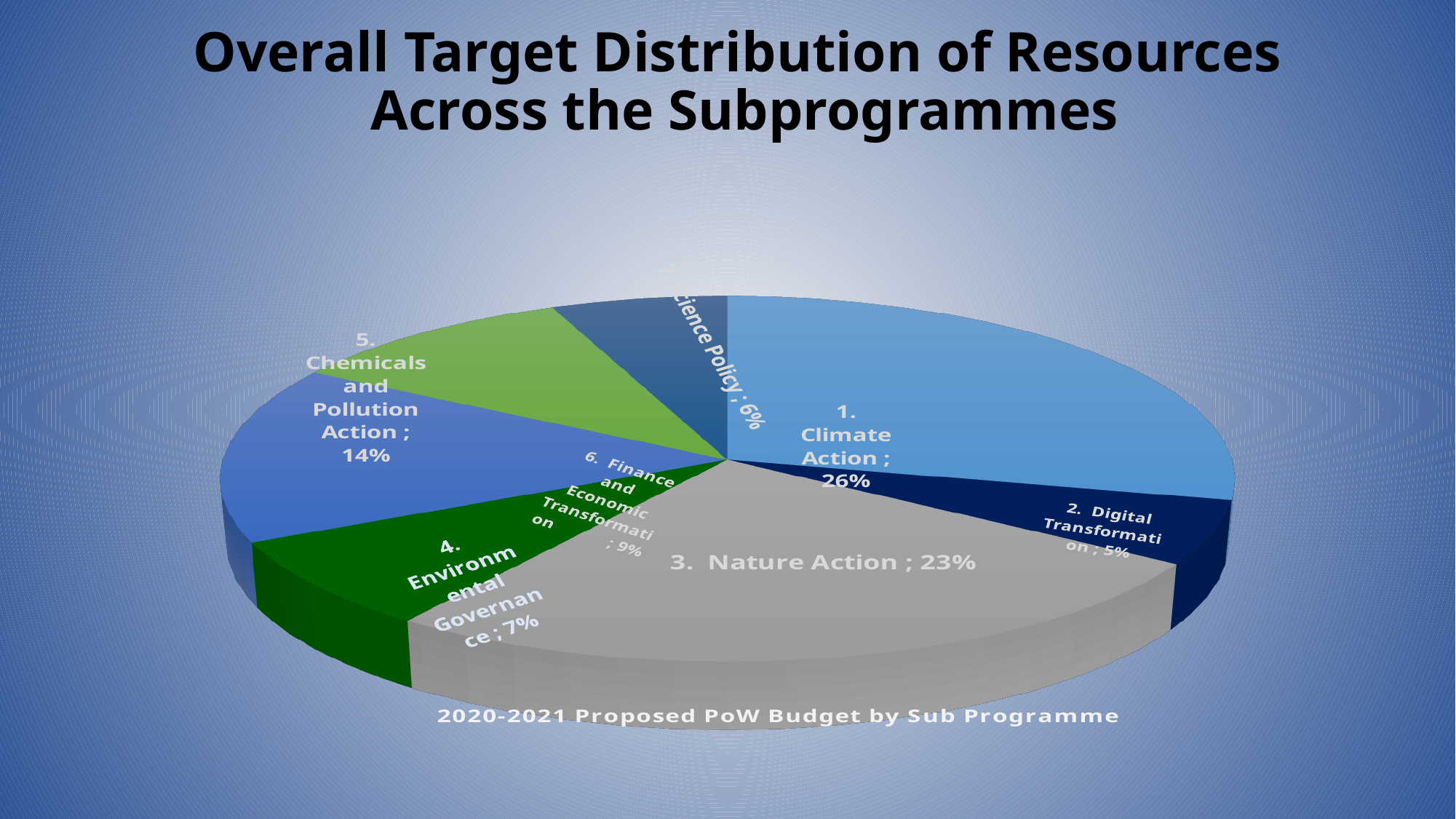
Which has a larger share, Environmental Governance or Finance and Economic Transformation? Finance and Economic Transformation What percentage share is shown for Chemicals and Pollution Action? 14% How many slices does the pie chart have? 7 What is the title printed below the pie chart? 2020-2021 Proposed PoW Budget by Sub Programme What type of chart is shown on the slide? Pie chart What percentage share is shown for Finance and Economic Transformation? 9% What is the difference in percentage points between Climate Action and Nature Action? 3 Which subprogramme has the smallest share of the pie? Digital Transformation What percentage share is shown for Digital Transformation? 5% What percentage share is shown for Nature Action? 23% Which subprogramme has the largest share of the pie? Climate Action What percentage share is shown for Climate Action? 26%